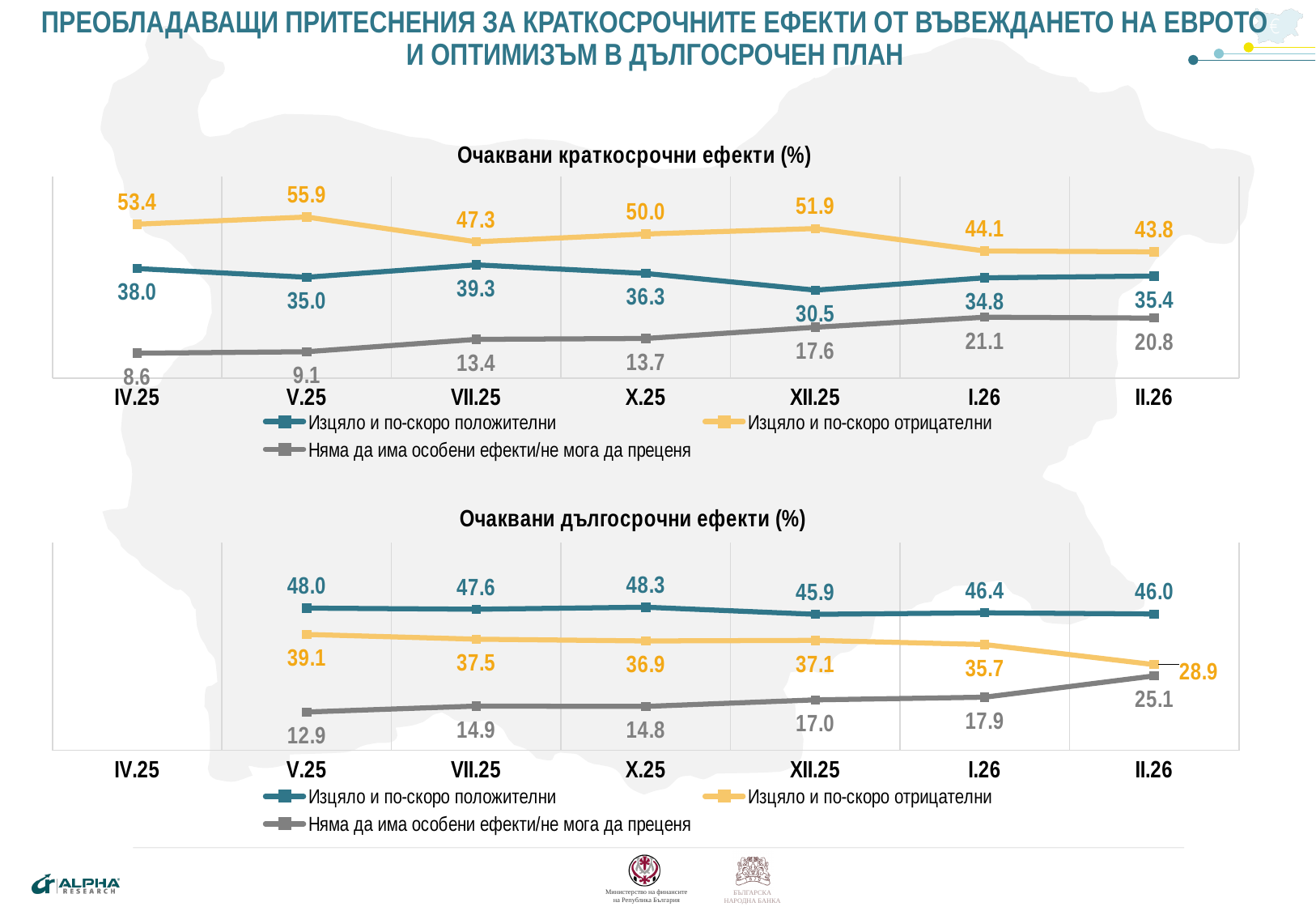
In the chart titled "Очаквани краткосрочни ефекти (%)", at which period is the "Изцяло и по-скоро отрицателни" series highest? V.25 In the chart titled "Очаквани дългосрочни ефекти (%)", does the "Няма да има особени ефекти/не мога да преценя" series generally rise or fall from V.25 to II.26? rise In the chart titled "Очаквани краткосрочни ефекти (%)", what is the value for "Изцяло и по-скоро отрицателни" at V.25? 55.9 How many series does the legend of the chart titled "Очаквани дългосрочни ефекти (%)" list? 3 In the chart titled "Очаквани краткосрочни ефекти (%)", at which period is the "Няма да има особени ефекти/не мога да преценя" series lowest? IV.25 In the chart titled "Очаквани дългосрочни ефекти (%)", what is the value for "Изцяло и по-скоро отрицателни" at II.26? 28.9 In the chart titled "Очаквани дългосрочни ефекти (%)", what is the value for "Изцяло и по-скоро положителни" at VII.25? 47.6 In the chart titled "Очаквани дългосрочни ефекти (%)", which is larger at I.26: "Изцяло и по-скоро положителни" or "Изцяло и по-скоро отрицателни"? Изцяло и по-скоро положителни In the chart titled "Очаквани краткосрочни ефекти (%)", what is the value for "Изцяло и по-скоро положителни" at XII.25? 30.5 What kind of chart is the chart titled "Очаквани краткосрочни ефекти (%)"? line chart In the chart titled "Очаквани краткосрочни ефекти (%)", how many time periods are plotted on the x axis? 7 In the chart titled "Очаквани краткосрочни ефекти (%)", what is the difference between "Изцяло и по-скоро отрицателни" and "Изцяло и по-скоро положителни" at II.26? 8.4